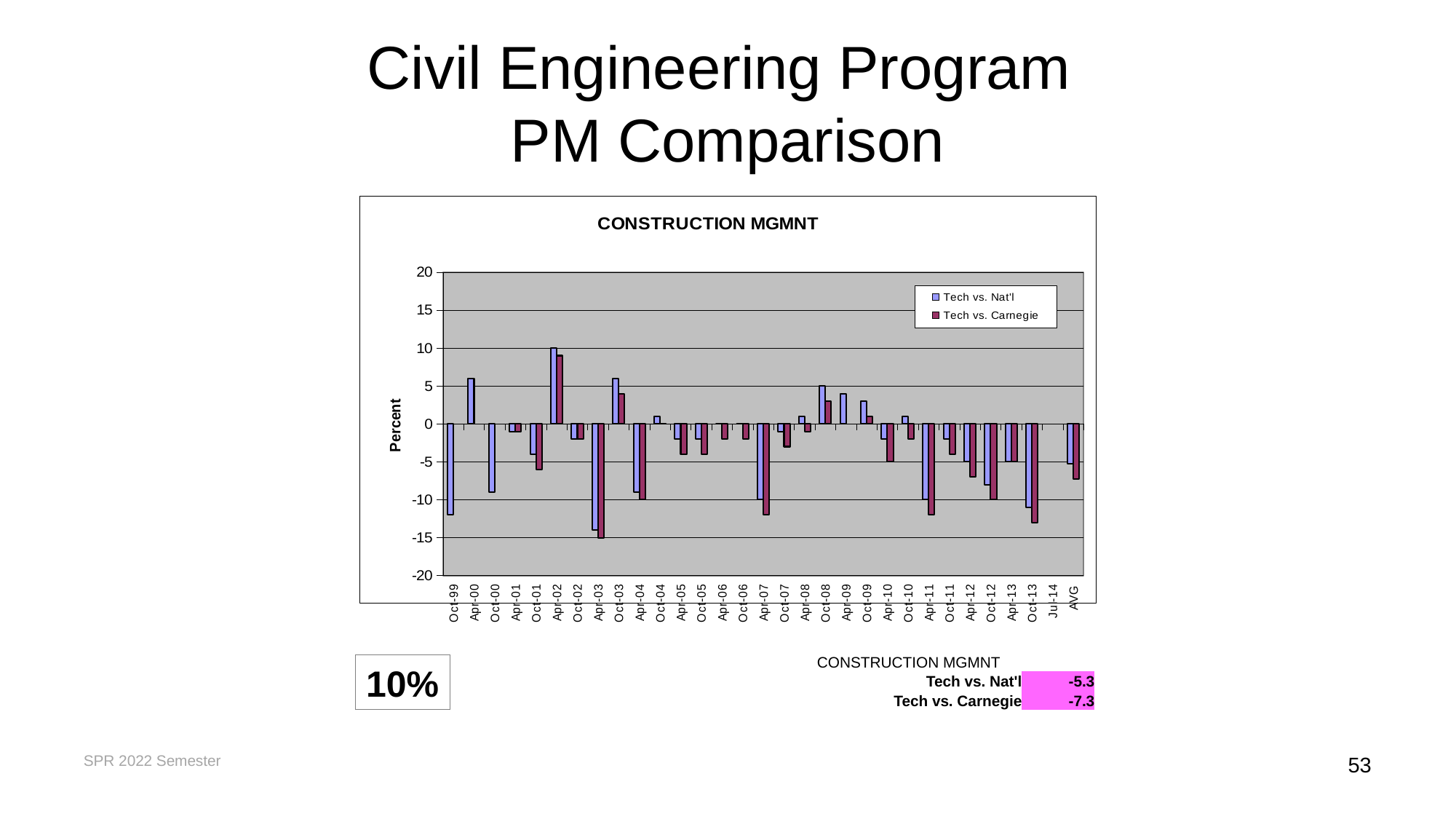
What is the AVG value for Tech vs. Nat'l? -5.3 Is the Tech vs. Carnegie value for Apr-02 greater or less than 5? greater In which period is the Tech vs. Nat'l value highest? Apr-02 How many series does the chart's legend list? 2 In which period is the Tech vs. Carnegie value lowest? Apr-03 Is the Tech vs. Nat'l value for Oct-99 greater or less than -10? less What is the label on the vertical axis of the chart? Percent What is the title of the chart? CONSTRUCTION MGMNT How many categories are shown along the x axis of the chart, including AVG? 31 What kind of chart is shown on the slide? bar chart What is the AVG value for Tech vs. Carnegie? -7.3 What is the difference between the AVG values for Tech vs. Nat'l and Tech vs. Carnegie? 2.0